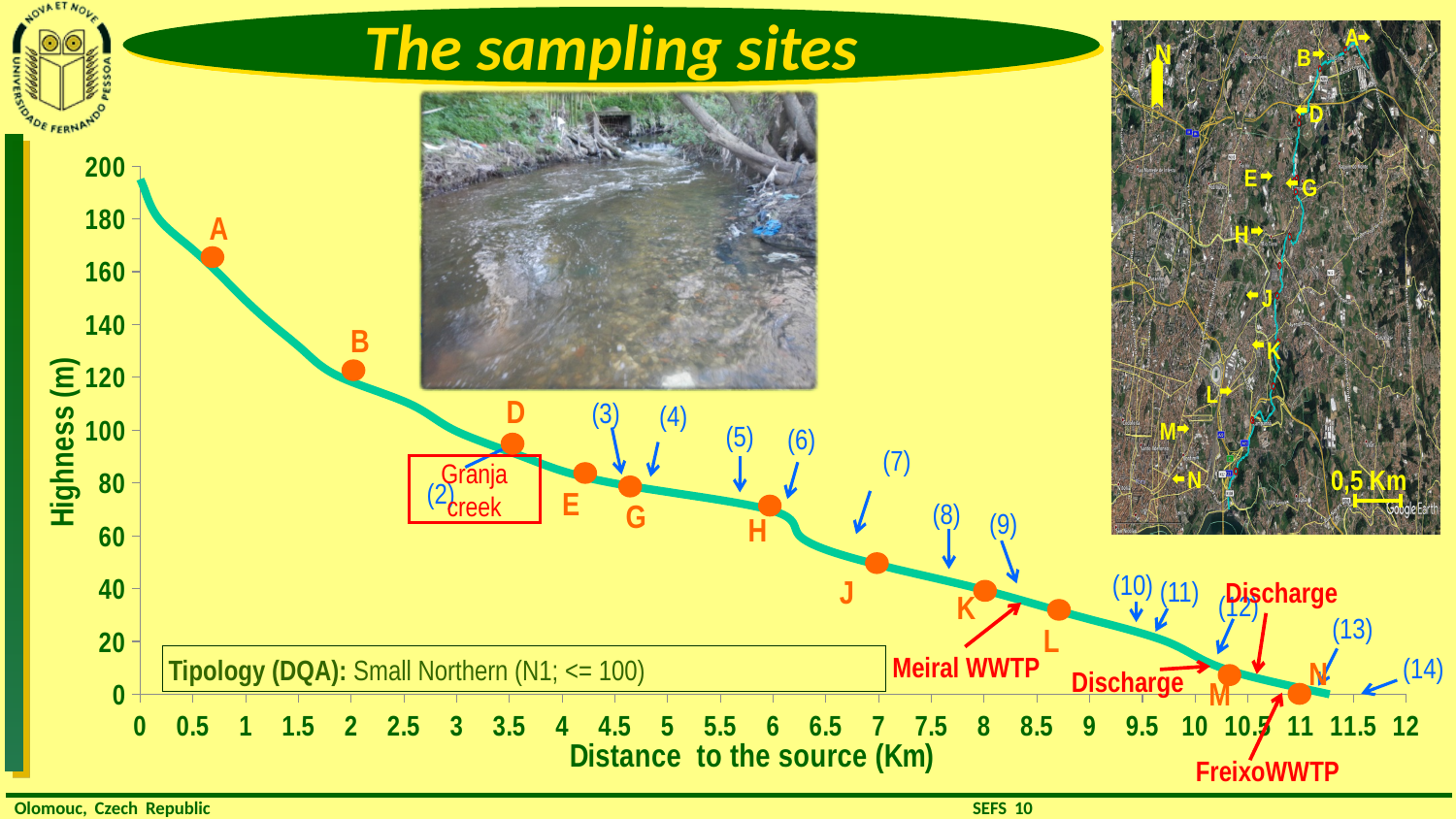
Does the height of the river profile rise or fall as the distance to the source increases? fall Which lettered sampling site has the lowest height on the chart? N Is the height at sampling site B greater or less than 140 m? less Is the height at sampling site J greater or less than 60 m? less Which sampling site is at a greater height, H or K? H What is the title of the y axis of the chart? Highness (m) Is the height at sampling site A greater or less than 140 m? greater What is the title of the x axis of the chart? Distance to the source (Km) What kind of chart is shown on the slide? line chart Which lettered sampling site has the highest height on the chart? A How many lettered sampling sites are marked as points on the chart? 11